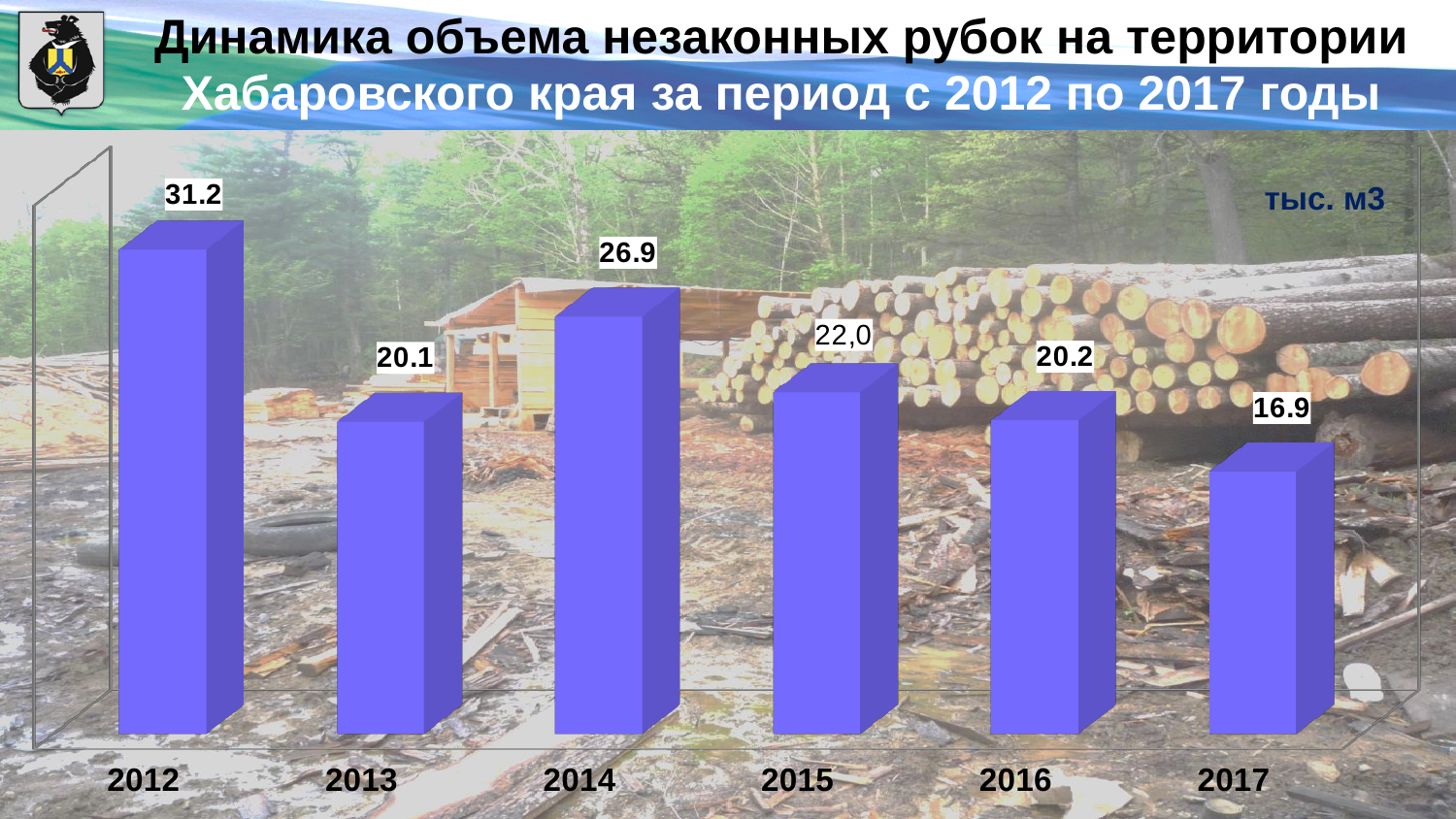
What unit of measurement is indicated on the chart? тыс. м3 What is the difference between the values for 2014 and 2013? 6.8 What kind of chart is shown on the slide? bar chart What is the value for 2017? 16.9 How many years are shown on the chart? 6 What is the value for 2014? 26.9 What is the value for 2012? 31.2 Which year has the highest value? 2012 What is the value for 2015? 22,0 What is the difference between the values for 2012 and 2017? 14.3 Which year has the lowest value? 2017 Which is larger, the value for 2014 or the value for 2015? 2014